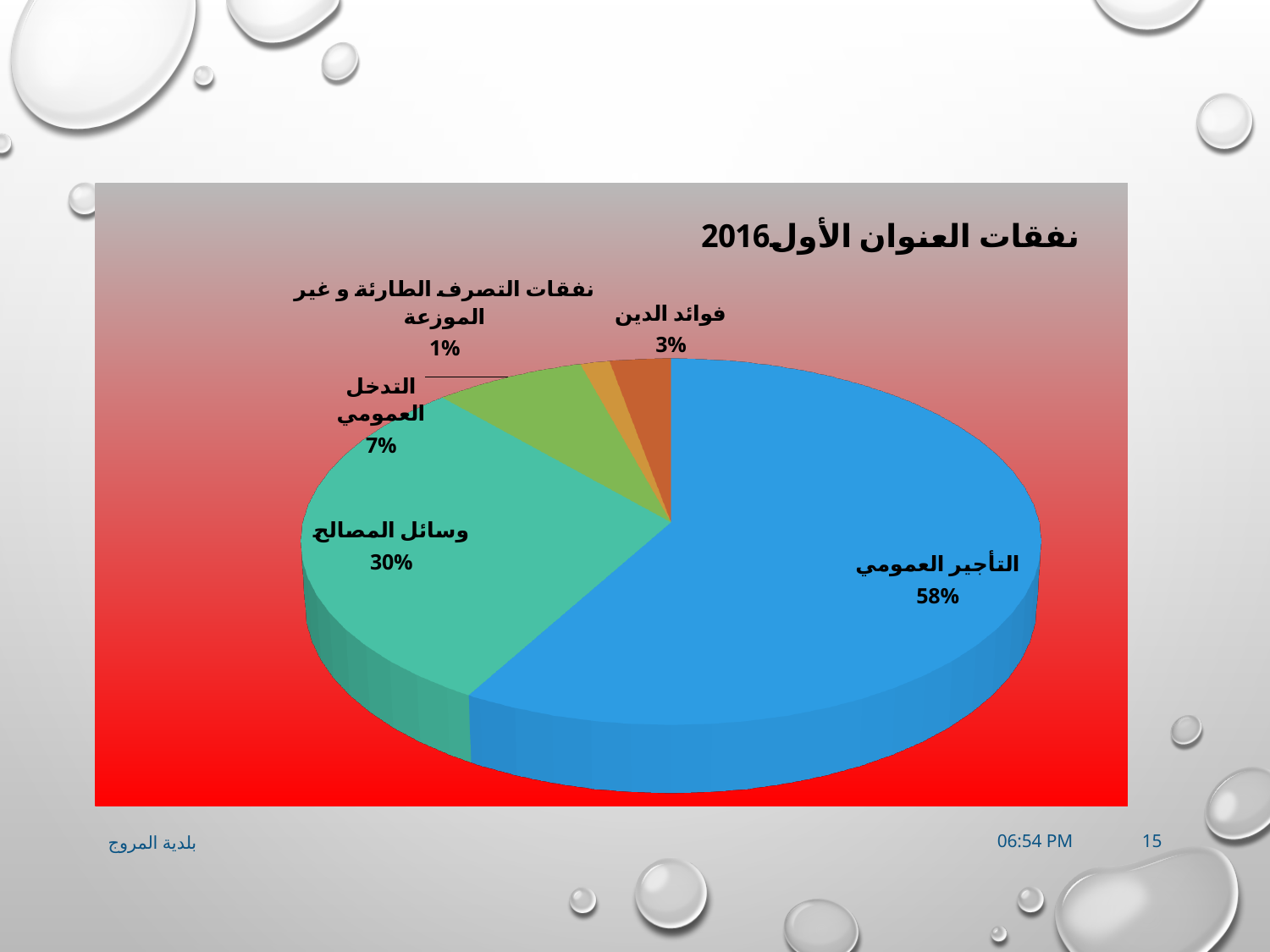
What share of the pie does التأجير العمومي represent? 58% What percentage is shown for التدخل العمومي? 7% Which category has the smallest slice of the pie? نفقات التصرف الطارئة و غير الموزعة Which is larger, the share for التدخل العمومي or the share for فوائد الدين? التدخل العمومي What percentage is shown for وسائل المصالح? 30% How many slices does the pie chart have? 5 What is the difference in percentage points between التأجير العمومي and وسائل المصالح? 28 What kind of chart is shown on the slide? Pie chart What is the title of the chart? نفقات العنوان الأول 2016 What percentage is shown for نفقات التصرف الطارئة و غير الموزعة? 1% Which category has the largest slice of the pie? التأجير العمومي What percentage is shown for فوائد الدين? 3%